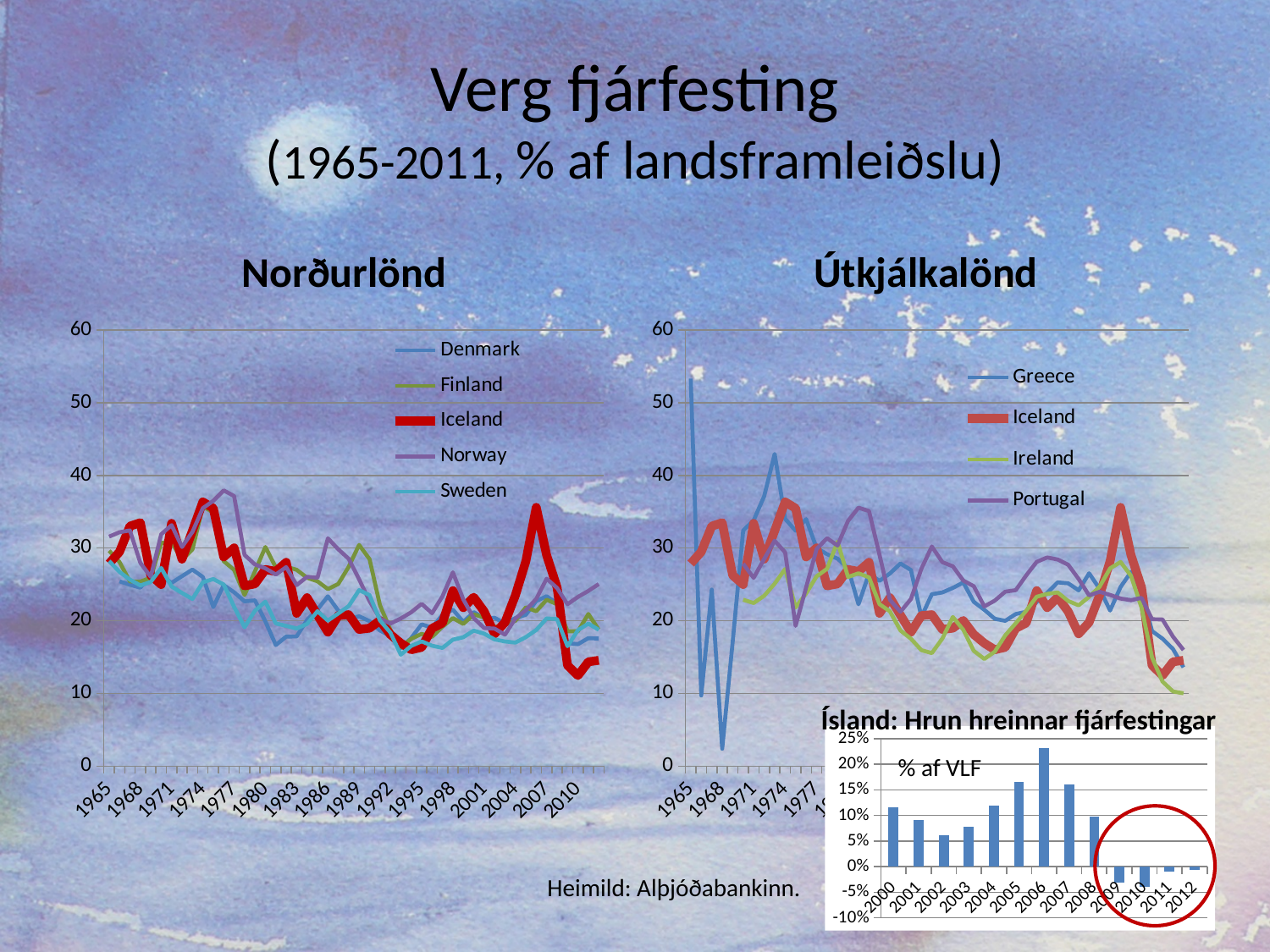
How many series does the legend of the 'Norðurlönd' chart list? 5 In the 'Ísland: Hrun hreinnar fjárfestingar' chart, how many years are shown on the x axis? 13 In the 'Ísland: Hrun hreinnar fjárfestingar' chart, which year has the highest bar? 2006 In the 'Útkjálkalönd' chart, is the value for Greece in 1965 greater or less than 50? greater In the 'Ísland: Hrun hreinnar fjárfestingar' chart, which is larger, the value for 2001 or the value for 2002? 2001 What kind of chart is the 'Norðurlönd' chart? line chart What kind of chart is the 'Ísland: Hrun hreinnar fjárfestingar' chart? bar chart In the 'Ísland: Hrun hreinnar fjárfestingar' chart, is the value for 2002 greater or less than 10%? less How many series does the legend of the 'Útkjálkalönd' chart list? 4 In the 'Norðurlönd' chart, does the Iceland line overall rise or fall from 1965 to 2011? fall Which series in the 'Útkjálkalönd' chart is drawn with a thick red line? Iceland In the 'Ísland: Hrun hreinnar fjárfestingar' chart, is the value for 2006 greater or less than 20%? greater